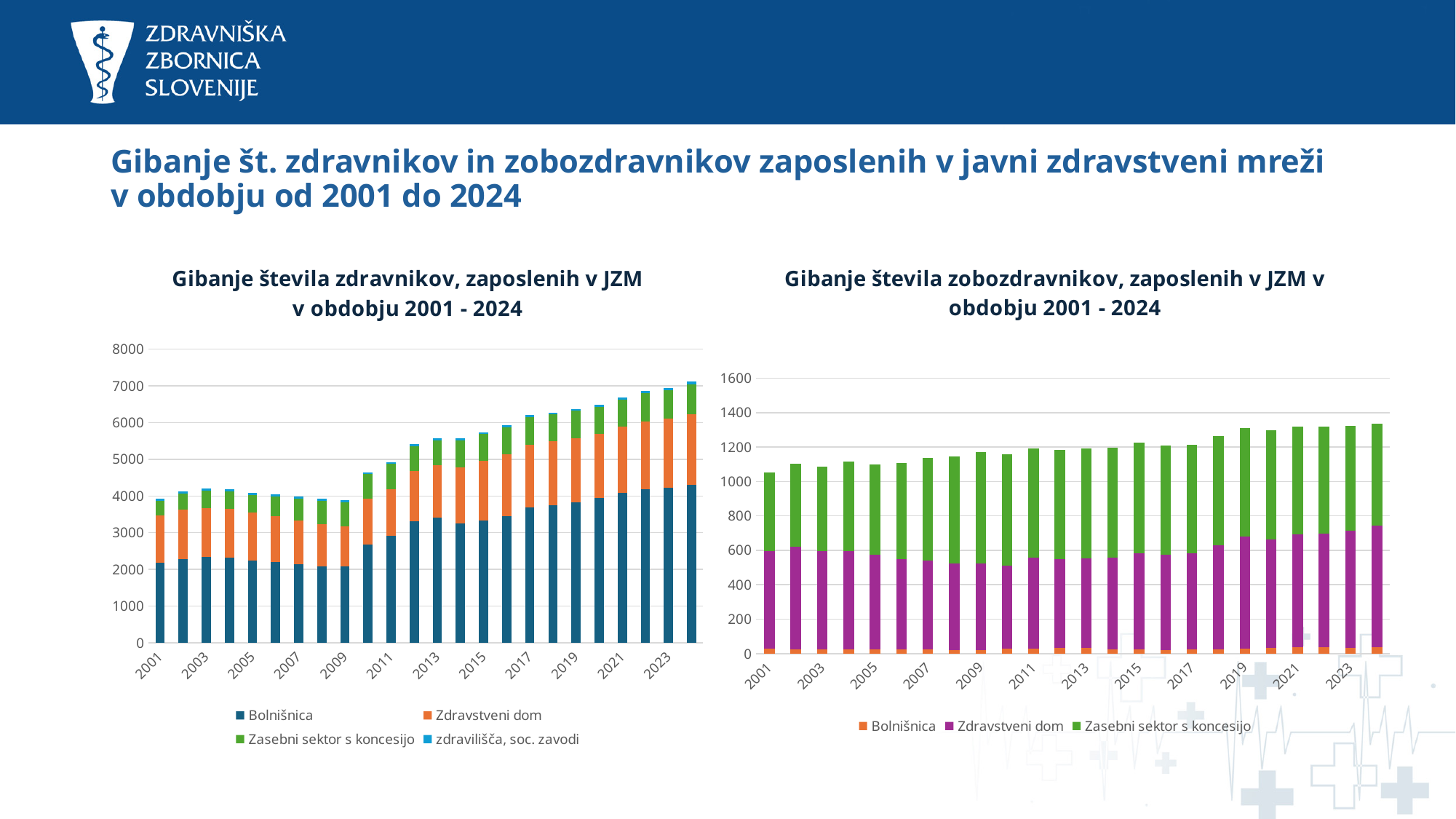
In the right chart (zobozdravnikov), is the total for 2001 greater or less than 1200? less In the right chart (zobozdravnikov), is the total for 2024 greater or less than 1200? greater In the left chart (zdravnikov), is the total for 2001 greater or less than 5000? less How many series does the legend of the left chart (zdravnikov) list? 4 In the left chart (zdravnikov), is the Bolnišnica value larger in 2001 or in 2024? 2024 What type of chart is the left chart, 'Gibanje števila zdravnikov, zaposlenih v JZM v obdobju 2001 - 2024'? Stacked bar chart In the left chart (zdravnikov), do the total values generally rise or fall from 2001 to 2024? Rise In the right chart (zobozdravnikov), which series is shown in purple? Zdravstveni dom In the left chart (zdravnikov), which year has the highest total number of doctors? 2024 How many years (bars) are plotted in the right chart, 'Gibanje števila zobozdravnikov, zaposlenih v JZM v obdobju 2001 - 2024'? 24 How many series does the legend of the right chart (zobozdravnikov) list? 3